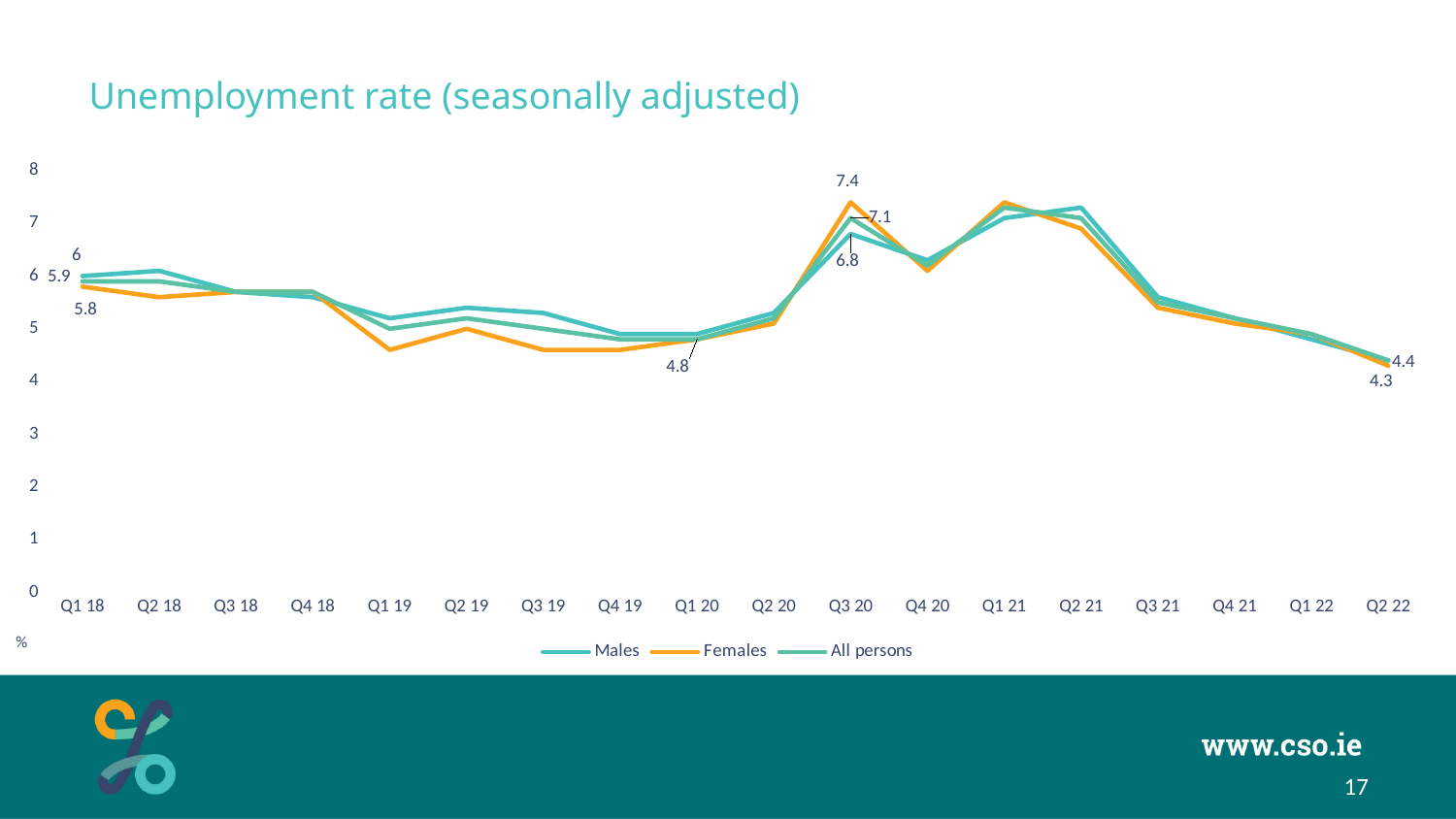
What is the unemployment rate for Males in Q1 18? 6 Do the unemployment rates rise or fall from Q2 21 to Q2 22? fall How many quarters are shown along the x axis? 18 Is the value for Females in Q1 19 greater or less than 5? less How many series does the legend list? 3 In Q3 20, which series has the highest unemployment rate? Females What kind of chart is shown on the slide? line chart What is the unemployment rate for Females in Q2 22? 4.3 What is the unemployment rate for Females in Q1 18? 5.8 What is the difference between the Males and Females unemployment rates in Q1 18? 0.2 What is the unemployment rate for Females in Q3 20? 7.4